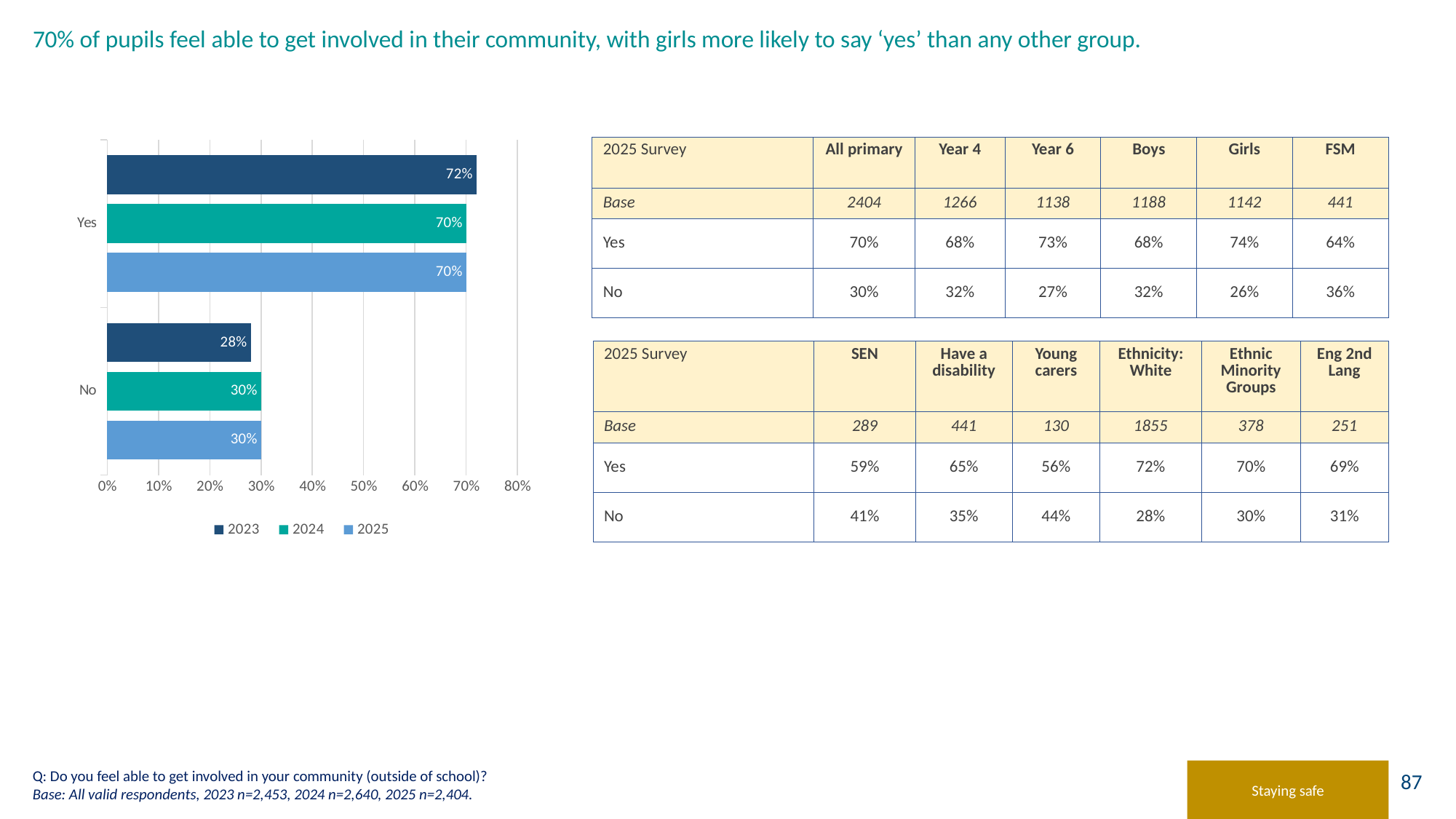
Which year had the lowest 'No' percentage? 2023 What kind of chart is shown on the slide? Bar chart How many response categories are shown on the chart? 2 Which year had the highest 'Yes' percentage? 2023 What percentage of pupils answered 'No' in 2024? 30% What percentage of pupils answered 'No' in 2023? 28% Which is larger: the 'No' percentage in 2023 or in 2025? 2025 How many series does the legend list? 3 What percentage of pupils answered 'Yes' in 2023? 72% What is the difference between the 'Yes' percentage in 2023 and in 2025? 2% What is the highest value shown on the x axis of the chart? 80% What percentage of pupils answered 'Yes' in 2025? 70%